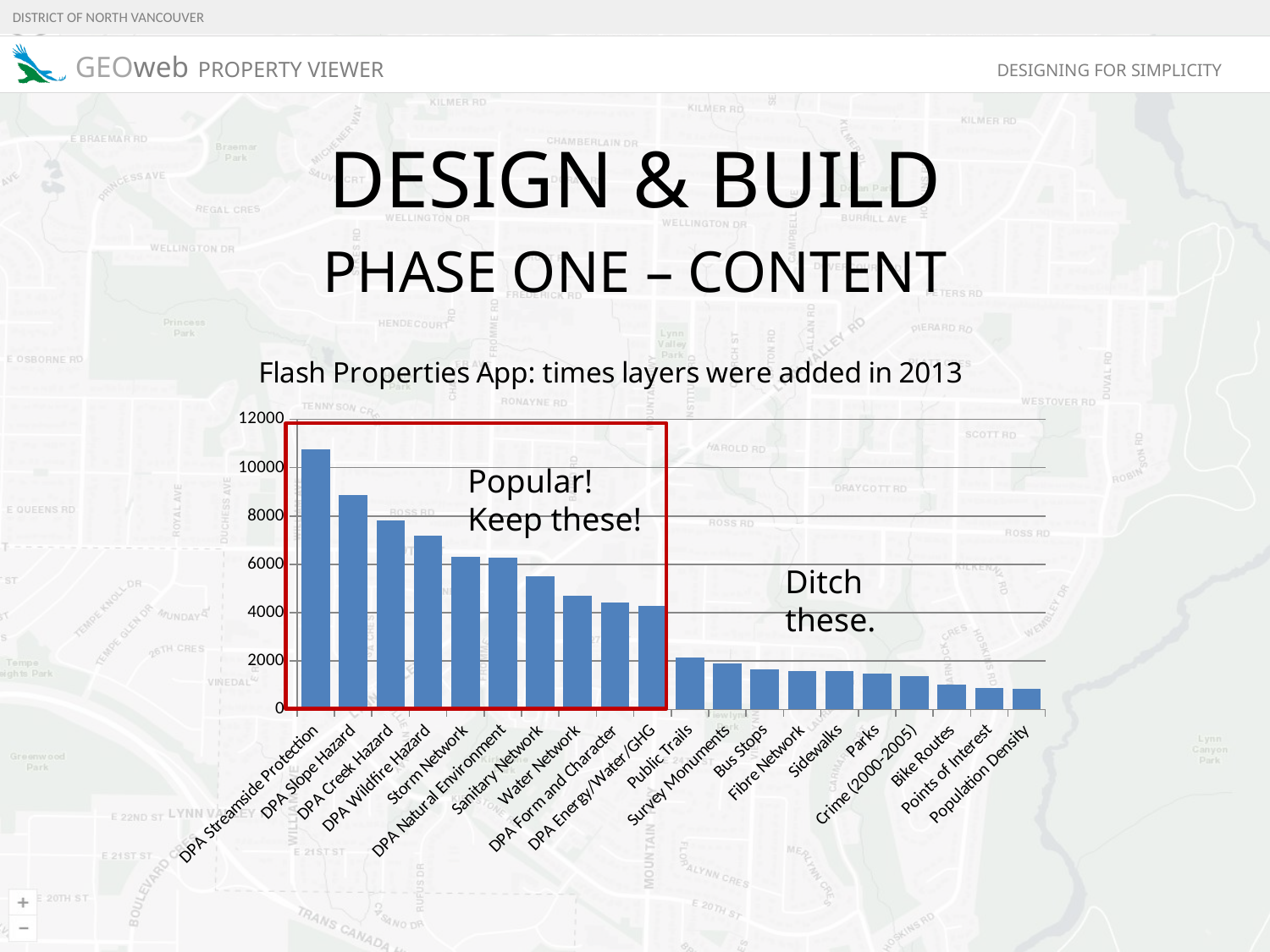
How many bars are enclosed by the red box labelled "Popular! Keep these!"? 10 What is the title of the chart? Flash Properties App: times layers were added in 2013 Is the value for Water Network greater or less than 6000? less Is the value for DPA Slope Hazard greater or less than 8000? greater Do the values generally rise or fall moving from left to right along the x axis? fall Which is larger, the value for DPA Creek Hazard or the value for Sanitary Network? DPA Creek Hazard Is the value for DPA Streamside Protection greater or less than 10000? greater Which is larger, the value for Public Trails or the value for Bike Routes? Public Trails How many layers (categories) are plotted in the chart? 20 Which layer has the highest number of times added? DPA Streamside Protection What kind of chart is shown on the slide? bar chart